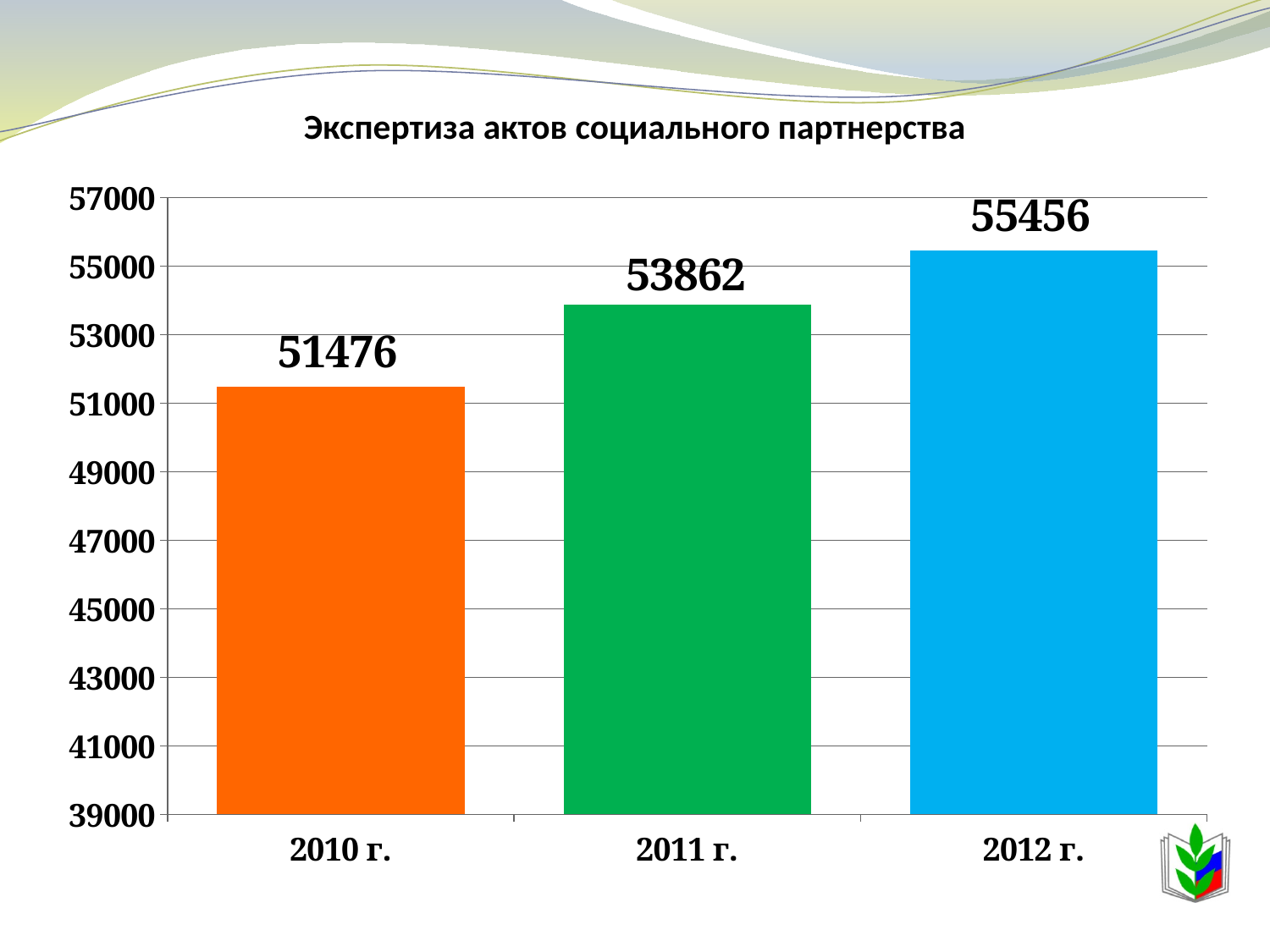
How many years are shown on the chart? 3 What is the difference between the values for 2011 г. and 2010 г.? 2386 Do the values rise or fall from 2010 г. to 2012 г.? rise Is the value for 2011 г. greater or less than 53000? greater What is the value for 2010 г.? 51476 What is the difference between the values for 2012 г. and 2010 г.? 3980 Which is larger, the value for 2011 г. or the value for 2012 г.? 2012 г. What kind of chart is shown on the slide? bar chart What is the value for 2011 г.? 53862 Which year has the highest value? 2012 г. What is the value for 2012 г.? 55456 Which year has the lowest value? 2010 г.